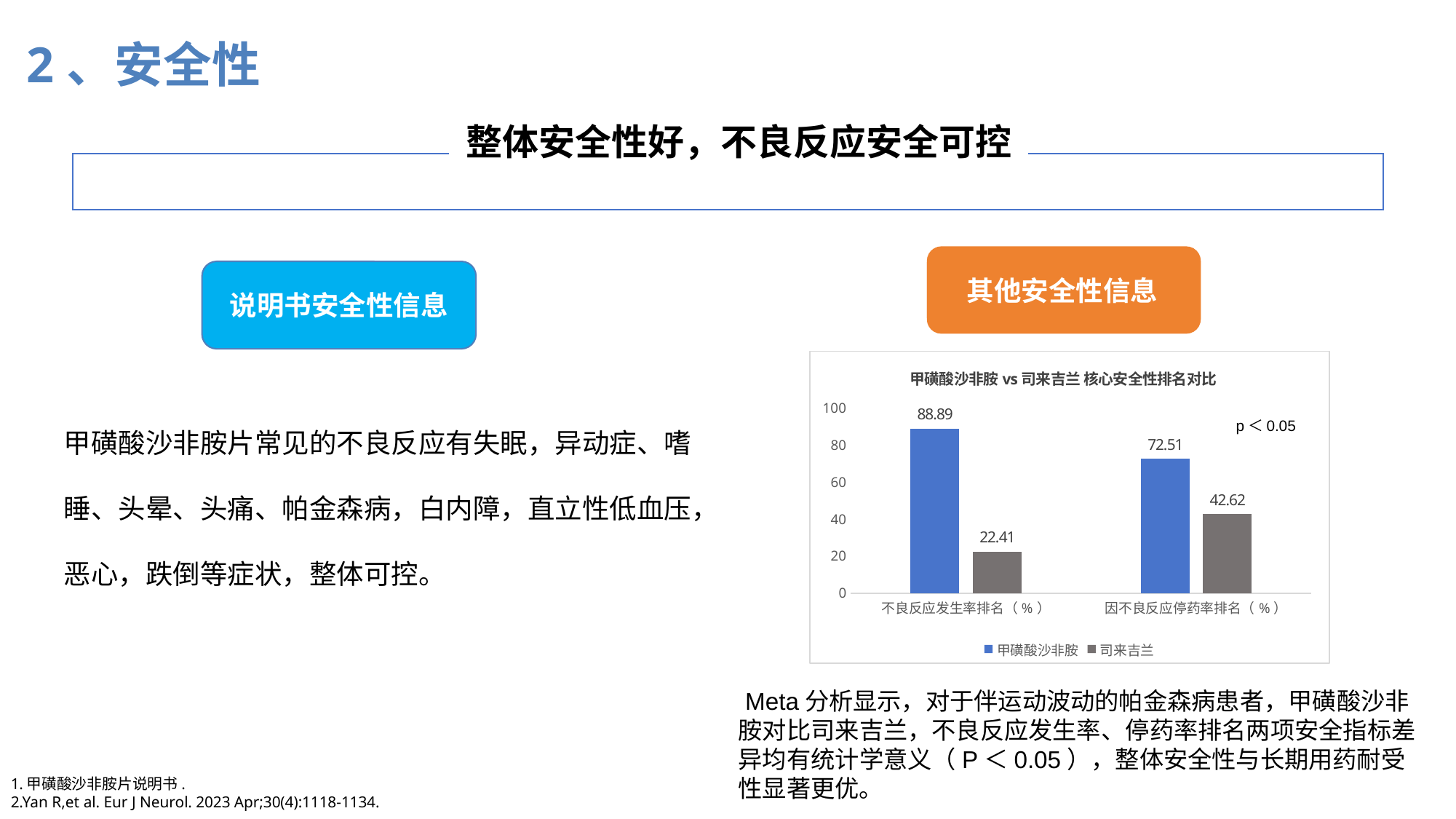
In the 因不良反应停药率排名（%） category, which series has the larger value, 甲磺酸沙非胺 or 司来吉兰? 甲磺酸沙非胺 What is the value for 甲磺酸沙非胺 in the 因不良反应停药率排名（%） category? 72.51 What type of chart is shown on the slide? Bar chart What is the value for 司来吉兰 in the 不良反应发生率排名（%） category? 22.41 What is the value for 甲磺酸沙非胺 in the 不良反应发生率排名（%） category? 88.89 What is the difference between 甲磺酸沙非胺 and 司来吉兰 in the 不良反应发生率排名（%） category? 66.48 Which bar has the lowest value in the chart? 司来吉兰, 不良反应发生率排名（%） What is the difference between 甲磺酸沙非胺 and 司来吉兰 in the 因不良反应停药率排名（%） category? 29.89 Which bar has the highest value in the chart? 甲磺酸沙非胺, 不良反应发生率排名（%） What is the title of the chart? 甲磺酸沙非胺 vs 司来吉兰 核心安全性排名对比 How many series does the legend list? 2 What is the value for 司来吉兰 in the 因不良反应停药率排名（%） category? 42.62